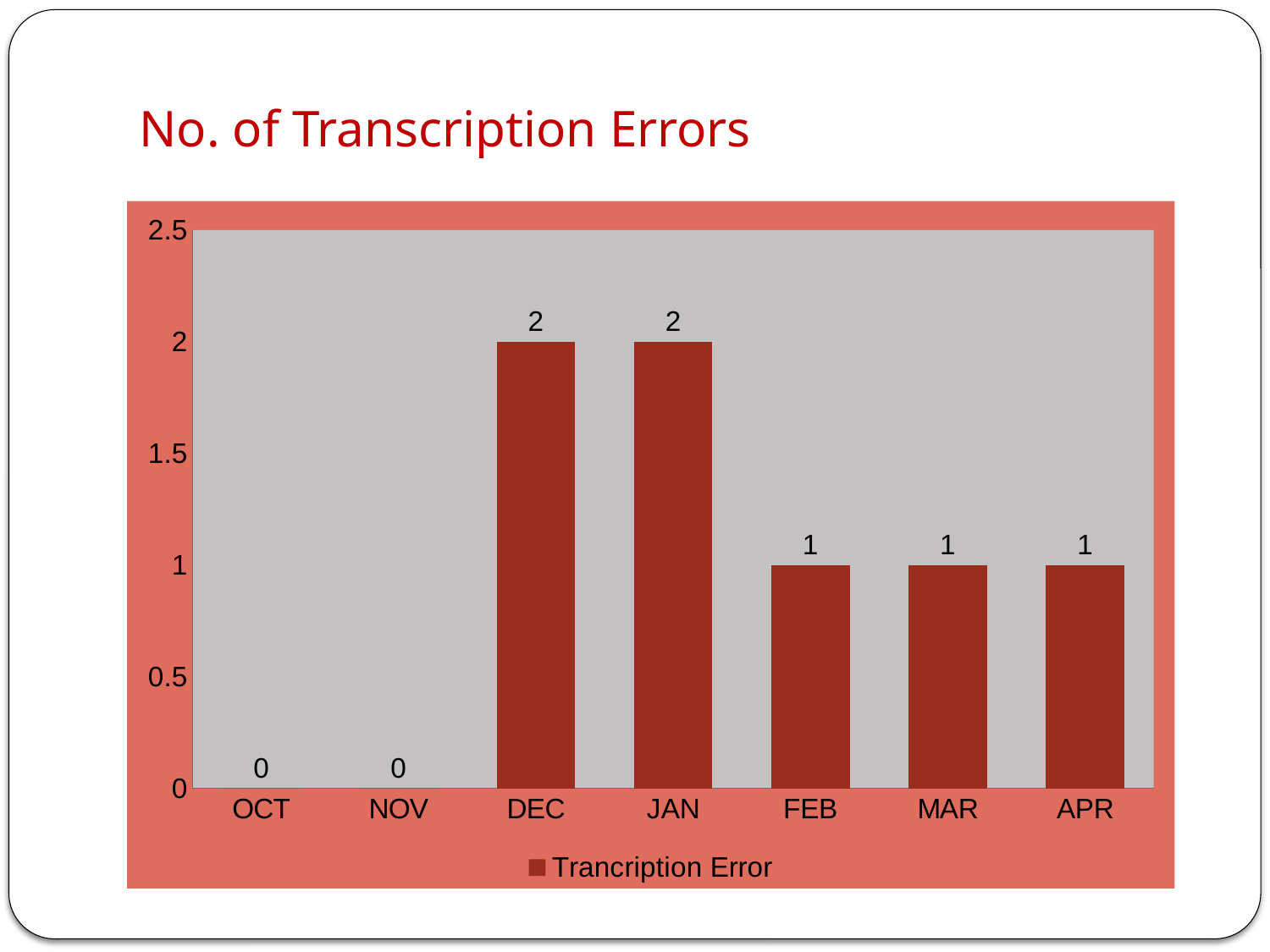
What is the value for MAR? 1 Which months have the highest number of transcription errors? DEC and JAN What is the value for FEB? 1 How many series does the legend list? 1 What kind of chart is shown on the slide? Bar chart Which months have the lowest number of transcription errors? OCT and NOV What is the value for OCT? 0 What is the difference between the values for JAN and APR? 1 Which is larger, the value for DEC or the value for FEB? DEC What is the value for DEC? 2 What is the title of the chart? No. of Transcription Errors How many months are shown on the x axis? 7